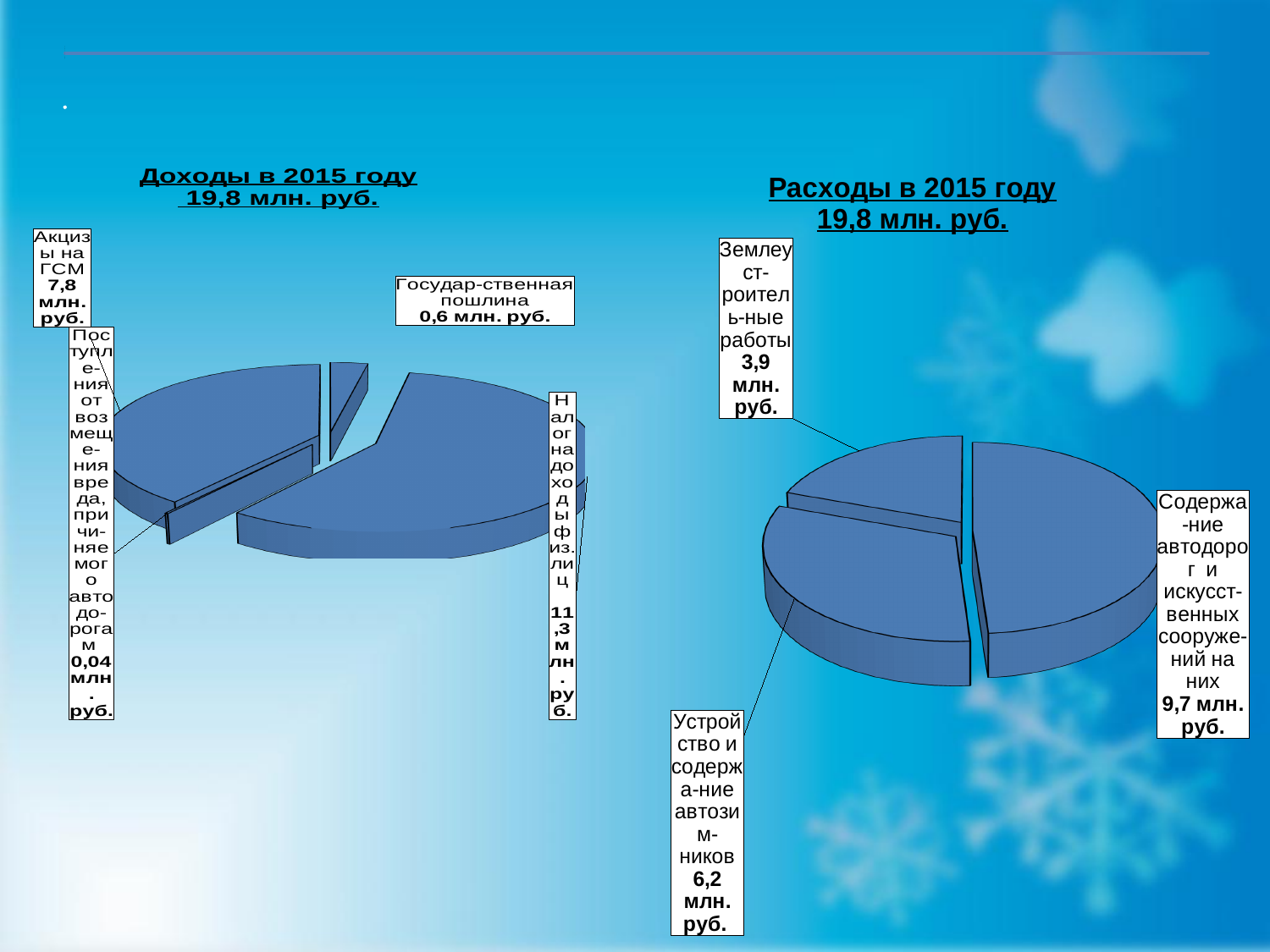
On the 'Доходы в 2015 году' chart, what is the difference between Налог на доходы физ. лиц and Акцизы на ГСМ? 3,5 млн. руб. On the 'Доходы в 2015 году' chart, what is the value for Акцизы на ГСМ? 7,8 млн. руб. On the 'Доходы в 2015 году' chart, what is the value for Государственная пошлина? 0,6 млн. руб. On the 'Доходы в 2015 году' chart, what is the value for Налог на доходы физ. лиц? 11,3 млн. руб. On the 'Доходы в 2015 году' chart, which category has the largest value? Налог на доходы физ. лиц On the 'Расходы в 2015 году' chart, which is larger: Устройство и содержание автозимников or Землеустроительные работы? Устройство и содержание автозимников On the 'Доходы в 2015 году' chart, which category has the smallest value? Поступления от возмещения вреда, причиняемого автодорогам On the 'Расходы в 2015 году' chart, what is the difference between Содержание автодорог и искусственных сооружений на них and Устройство и содержание автозимников? 3,5 млн. руб. How many categories does the 'Расходы в 2015 году' chart show? 3 On the 'Расходы в 2015 году' chart, which category has the largest value? Содержание автодорог и искусственных сооружений на них What type of chart is used for 'Доходы в 2015 году'? Pie chart On the 'Расходы в 2015 году' chart, what is the value for Землеустроительные работы? 3,9 млн. руб.